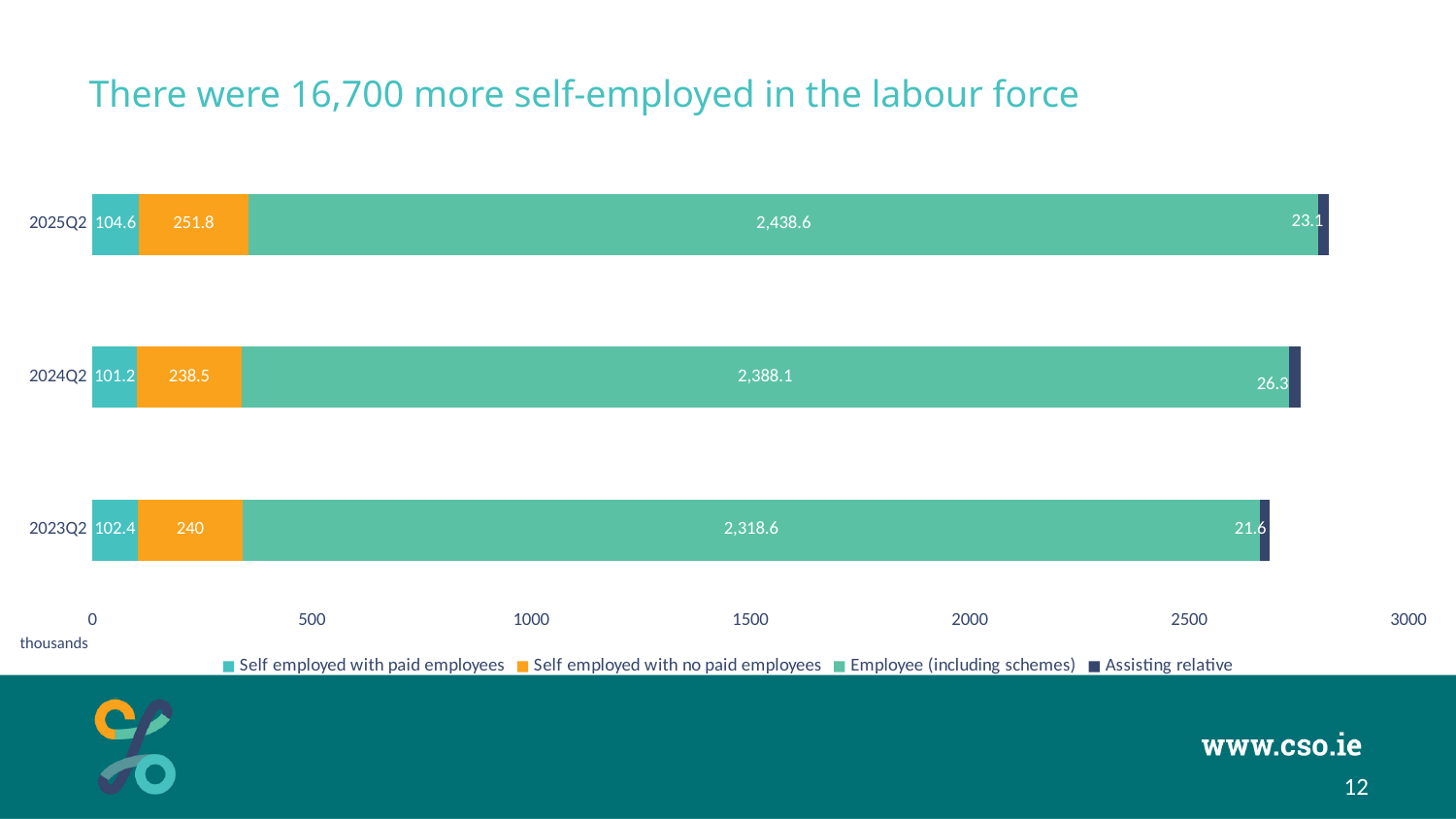
What is the value for Employee (including schemes) in 2025Q2? 2,438.6 What kind of chart is shown on the slide? Stacked bar chart What is the value for Self employed with no paid employees in 2024Q2? 238.5 What is the value for Self employed with paid employees in 2025Q2? 104.6 What is the value for Assisting relative in 2023Q2? 21.6 Which quarter has the lowest value for Assisting relative? 2023Q2 Which is larger: Self employed with no paid employees in 2025Q2 or in 2023Q2? 2025Q2 Which quarter has the highest value for Employee (including schemes)? 2025Q2 How many series does the legend list? 4 What is the difference between the Employee (including schemes) values for 2025Q2 and 2024Q2? 50.5 How many quarters are shown on the chart? 3 What is the total of the stacked bar for 2025Q2? 2,818.1